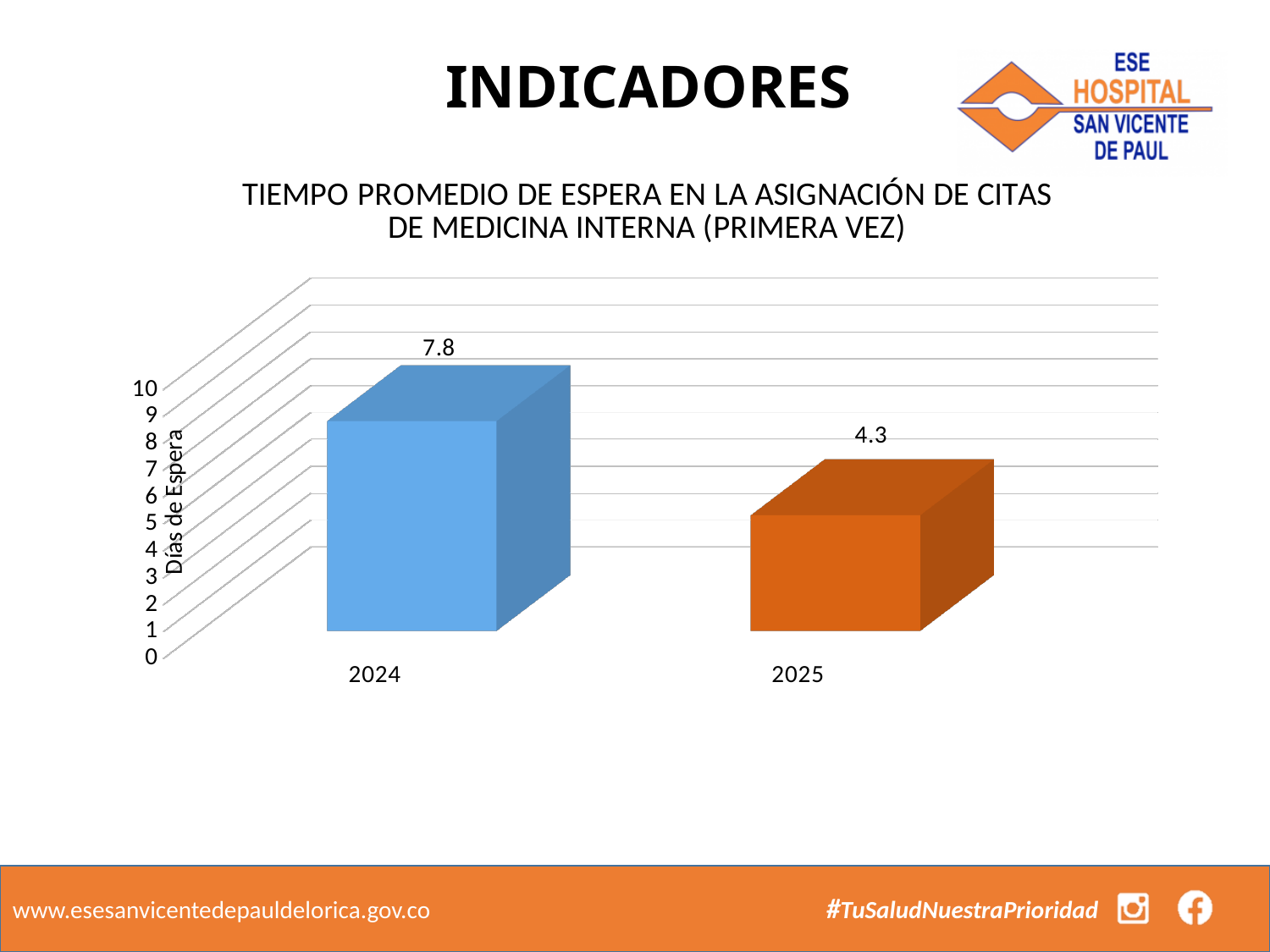
What is the value for 2025? 4.3 Do the values rise or fall from 2024 to 2025? fall Which year has the lowest value? 2025 What is the value for 2024? 7.8 What is the label of the vertical axis? Días de Espera What kind of chart is shown on the slide? bar chart How many categories are shown on the x axis? 2 Which is larger, the value for 2024 or the value for 2025? 2024 Is the value for 2025 greater or less than 5? less What is the difference between the values for 2024 and 2025? 3.5 Which year has the highest value? 2024 What colour is the bar for 2025? orange